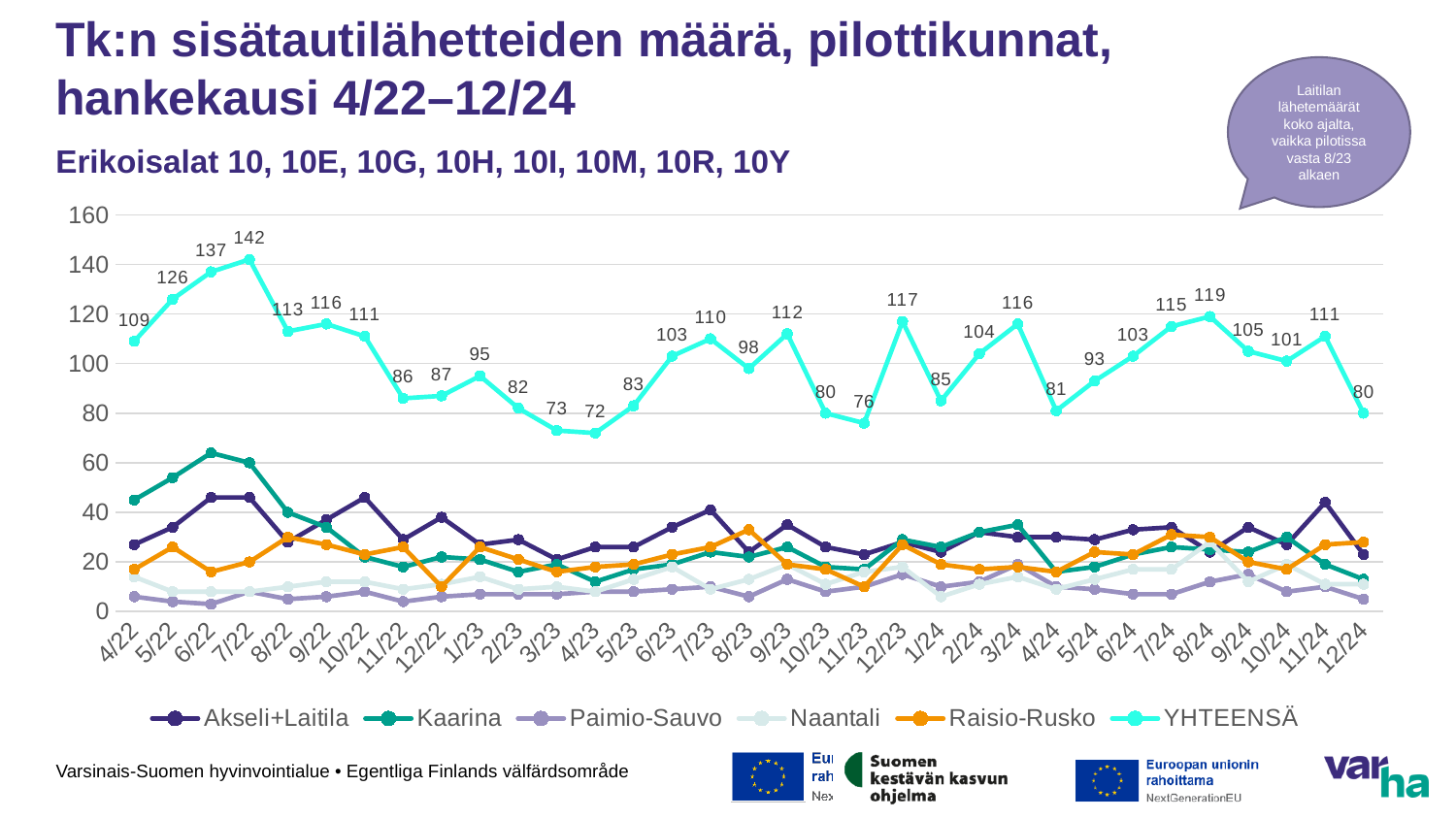
In which month does the YHTEENSÄ series reach its highest value? 7/22 What is the YHTEENSÄ value for 4/23? 72 What is the YHTEENSÄ value for 12/24? 80 In which month does the YHTEENSÄ series reach its lowest value? 4/23 What is the YHTEENSÄ value for 7/22? 142 What kind of chart is shown on the slide? line chart Is the value for Kaarina in 6/22 greater or less than 40? greater How many months are plotted on the x axis? 33 Which month has the larger YHTEENSÄ value, 12/23 or 1/24? 12/23 How many series does the legend list? 6 What is the difference between the YHTEENSÄ values for 7/22 and 12/24? 62 What is the difference between the YHTEENSÄ values for 9/23 and 8/23? 14